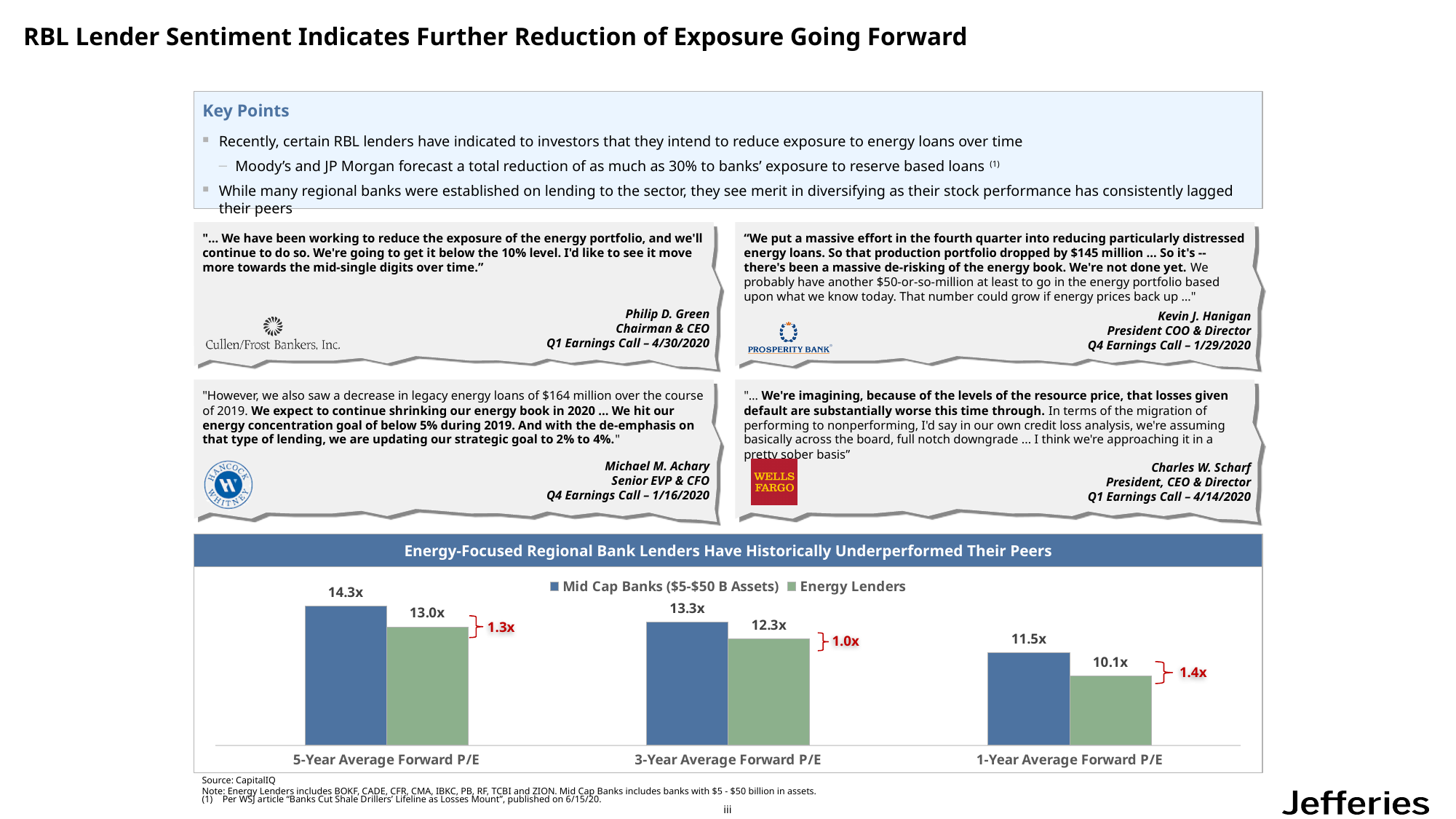
What is the difference between Mid Cap Banks and Energy Lenders for the 3-Year Average Forward P/E? 1.0x Which category has the highest value for Energy Lenders? 5-Year Average Forward P/E Which category has the lowest value for Mid Cap Banks ($5-$50 B Assets)? 1-Year Average Forward P/E How many series does the chart legend list? 2 What is the title of the chart? Energy-Focused Regional Bank Lenders Have Historically Underperformed Their Peers What kind of chart is shown on the slide? Bar chart Which is larger for the 5-Year Average Forward P/E: Mid Cap Banks or Energy Lenders? Mid Cap Banks What is the 5-Year Average Forward P/E for Mid Cap Banks ($5-$50 B Assets)? 14.3x How many categories are shown on the x axis of the chart? 3 What is the 1-Year Average Forward P/E for Energy Lenders? 10.1x What is the difference between Mid Cap Banks and Energy Lenders for the 1-Year Average Forward P/E? 1.4x What is the 3-Year Average Forward P/E for Energy Lenders? 12.3x